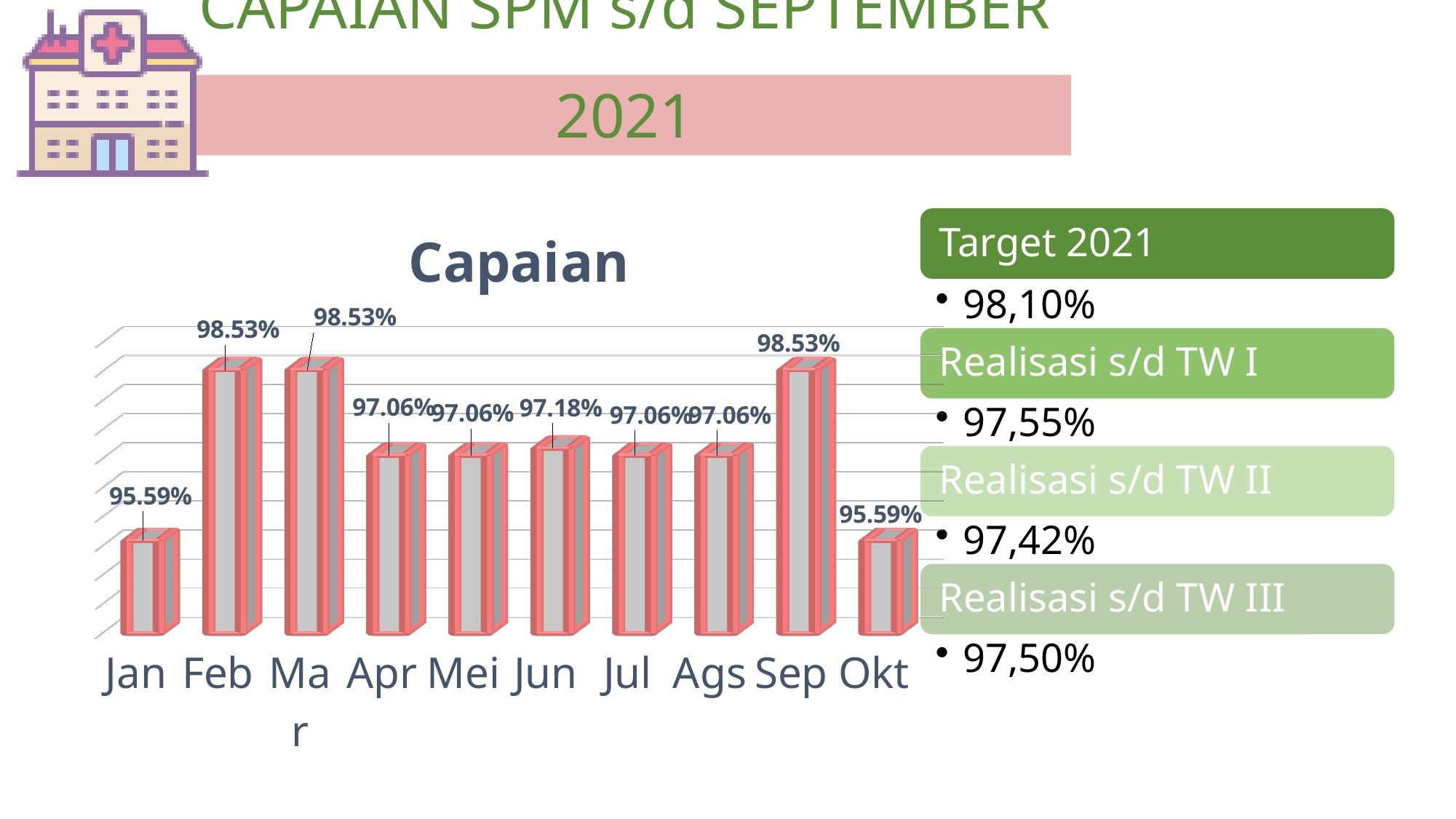
What is the difference between the values for Feb and Jan in the Capaian chart? 2.94% How many months are shown on the x axis of the Capaian chart? 10 Does the value rise or fall from Sep to Okt in the Capaian chart? Fall Which months share the lowest value in the Capaian chart? Jan and Okt What kind of chart is the Capaian chart? Bar chart What is the value for Apr in the Capaian chart? 97.06% What is the value for Jun in the Capaian chart? 97.18% What is the value for Jan in the Capaian chart? 95.59% What is the value for Sep in the Capaian chart? 98.53% Which has a larger value in the Capaian chart, Feb or Apr? Feb What is the difference between the values for Jun and Apr in the Capaian chart? 0.12% What is the highest value shown in the Capaian chart? 98.53%